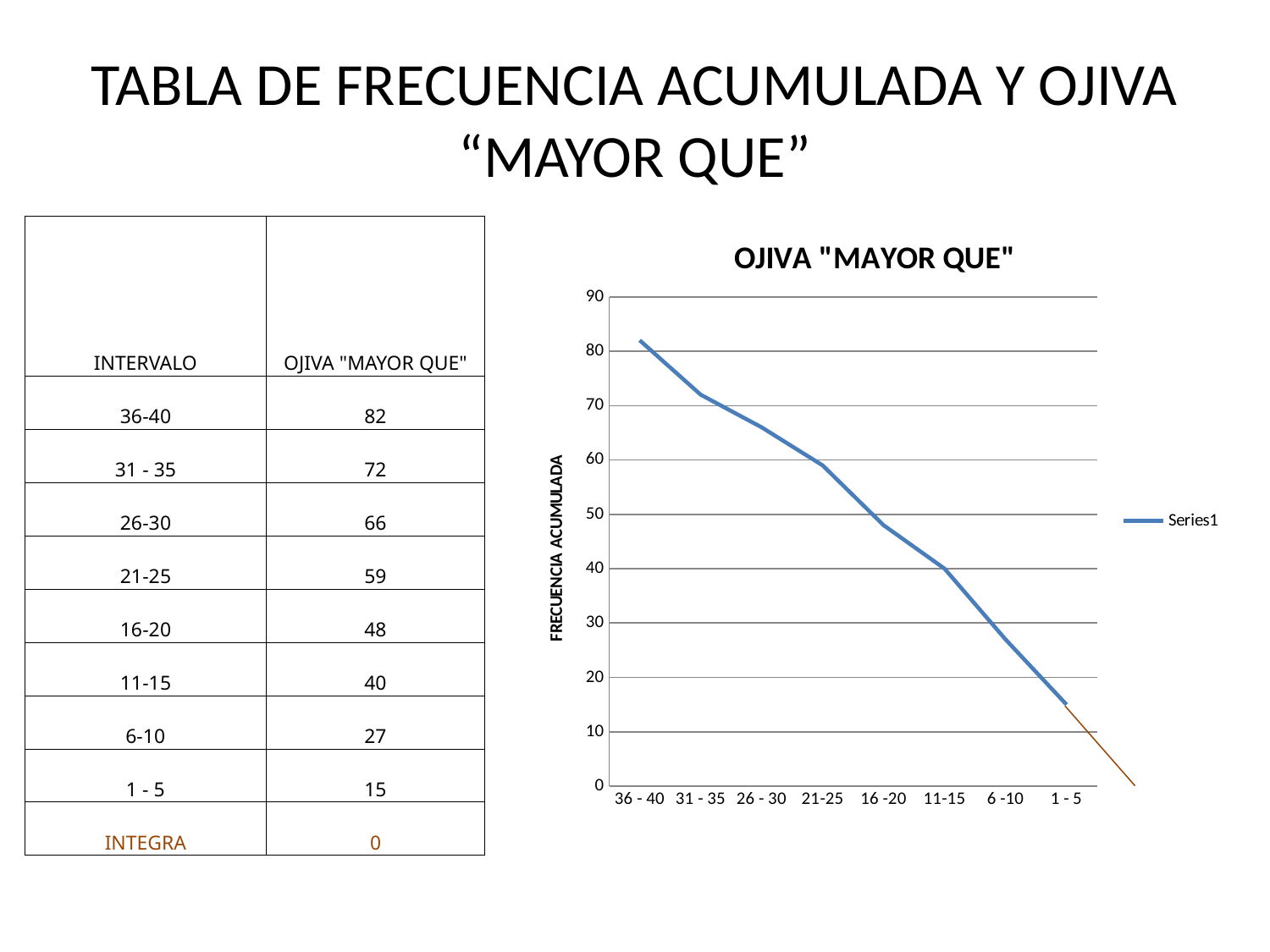
Which interval has the lowest cumulative frequency in the chart? 1 - 5 What is the difference between the values for 36-40 and 1 - 5 in the table? 67 Which interval has the highest cumulative frequency in the chart? 36 - 40 According to the table, what is the OJIVA "MAYOR QUE" value for the interval 6-10? 27 How many series does the chart legend list? 1 Do the values rise or fall along the x axis from 36 - 40 to 1 - 5? fall What is the title of the chart? OJIVA "MAYOR QUE" Is the value for 16 -20 in the chart greater or less than 50? less How many categories are shown on the x axis of the chart? 8 What kind of chart is shown on the slide? line chart According to the table, what is the OJIVA "MAYOR QUE" value for the interval 21-25? 59 Which is larger, the value for 31 - 35 or the value for 11-15? 31 - 35